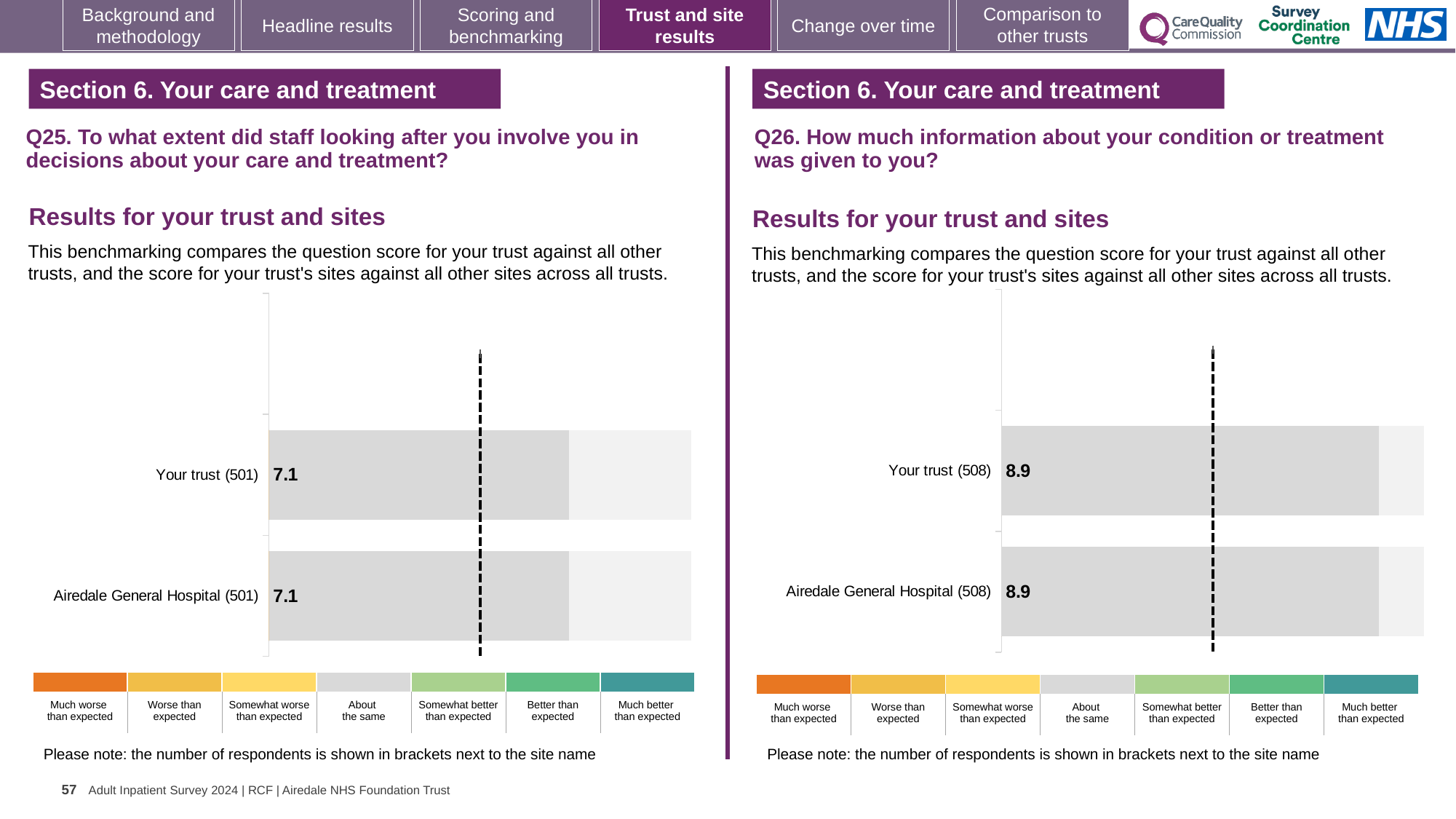
How many bars are plotted in the Q25 chart on the left? 2 In the Q26 chart on the right, what is the difference between the score for Your trust and the score for Airedale General Hospital? 0 In the Q25 chart on the left, what is the difference between the score for Your trust and the score for Airedale General Hospital? 0 In the Q26 chart on the right, what is the score for Your trust? 8.9 In the Q26 chart on the right, how many respondents are shown in brackets next to Airedale General Hospital? 508 In the Q25 chart on the left, what is the score for Your trust? 7.1 In the Q26 chart on the right, what is the score for Airedale General Hospital? 8.9 In the Q25 chart on the left, what is the score for Airedale General Hospital? 7.1 In the Q25 chart on the left, how many respondents are shown in brackets next to Your trust? 501 How many bars are plotted in the Q26 chart on the right? 2 What kind of chart is the Q26 chart on the right? Bar chart